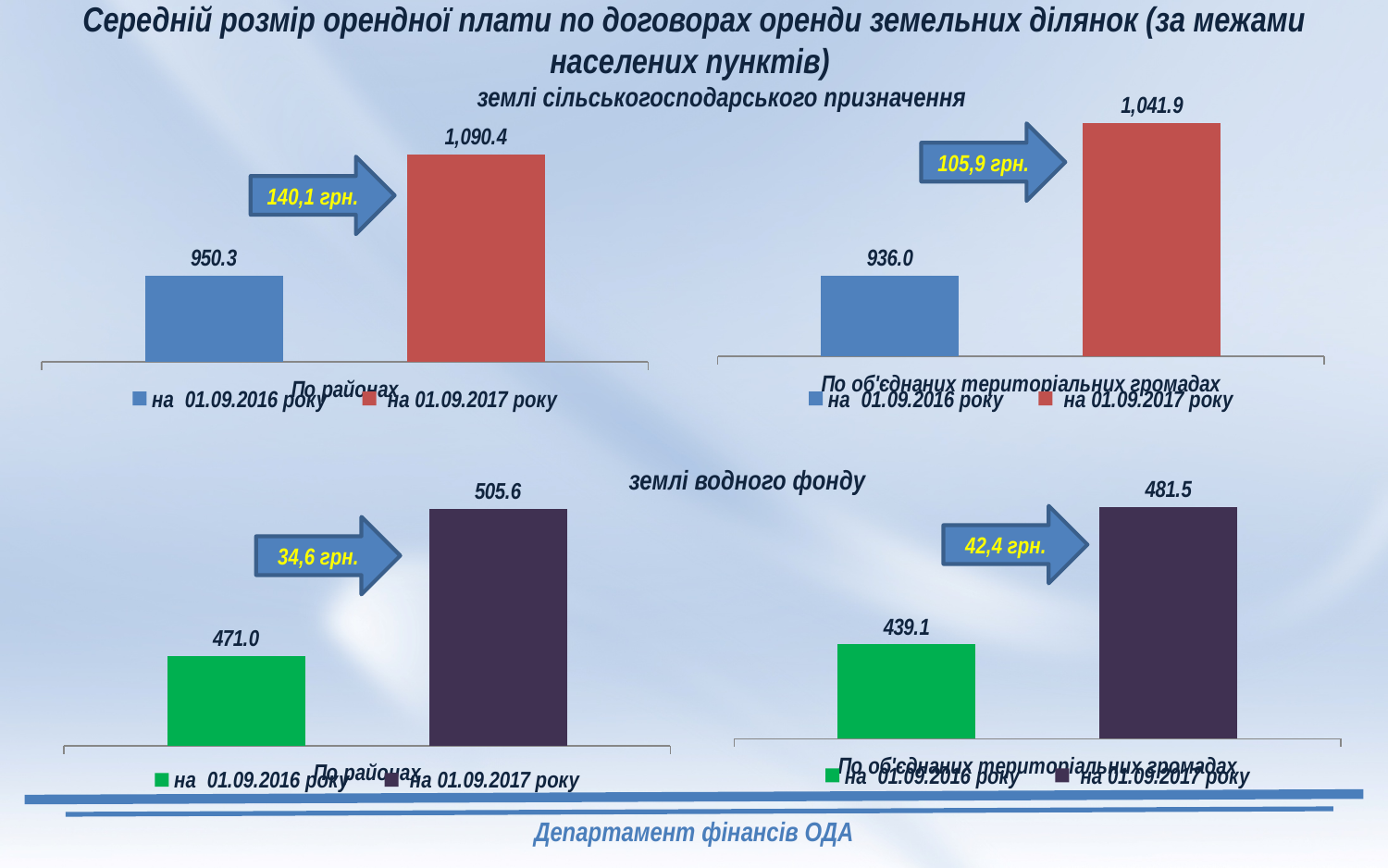
What type of chart is the bottom-left chart (землі водного фонду, По районах)? bar chart In the bottom-right chart (землі водного фонду, По об'єднаних територіальних громадах), what is the value for на 01.09.2017 року? 481.5 In the bottom-right chart (землі водного фонду, По об'єднаних територіальних громадах), which series has the lower value? на 01.09.2016 року In the top-left chart (землі сільськогосподарського призначення, По районах), which is larger: the 2016 value or the 2017 value? на 01.09.2017 року In the top-left chart (землі сільськогосподарського призначення, По районах), what is the value for на 01.09.2016 року? 950.3 In the bottom-left chart (землі водного фонду, По районах), what is the difference between the 2017 and 2016 values? 34.6 In the top-right chart (землі сільськогосподарського призначення, По об'єднаних територіальних громадах), what is the value for на 01.09.2017 року? 1,041.9 In the top-left chart (землі сільськогосподарського призначення, По районах), what is the value for на 01.09.2017 року? 1,090.4 In the top-right chart (землі сільськогосподарського призначення, По об'єднаних територіальних громадах), what is the difference between the 2017 and 2016 values? 105.9 How many series does the legend of the top-right chart list? 2 In the bottom-right chart (землі водного фонду, По об'єднаних територіальних громадах), what colour is the bar for на 01.09.2016 року? green In the bottom-left chart (землі водного фонду, По районах), what is the value for на 01.09.2016 року? 471.0